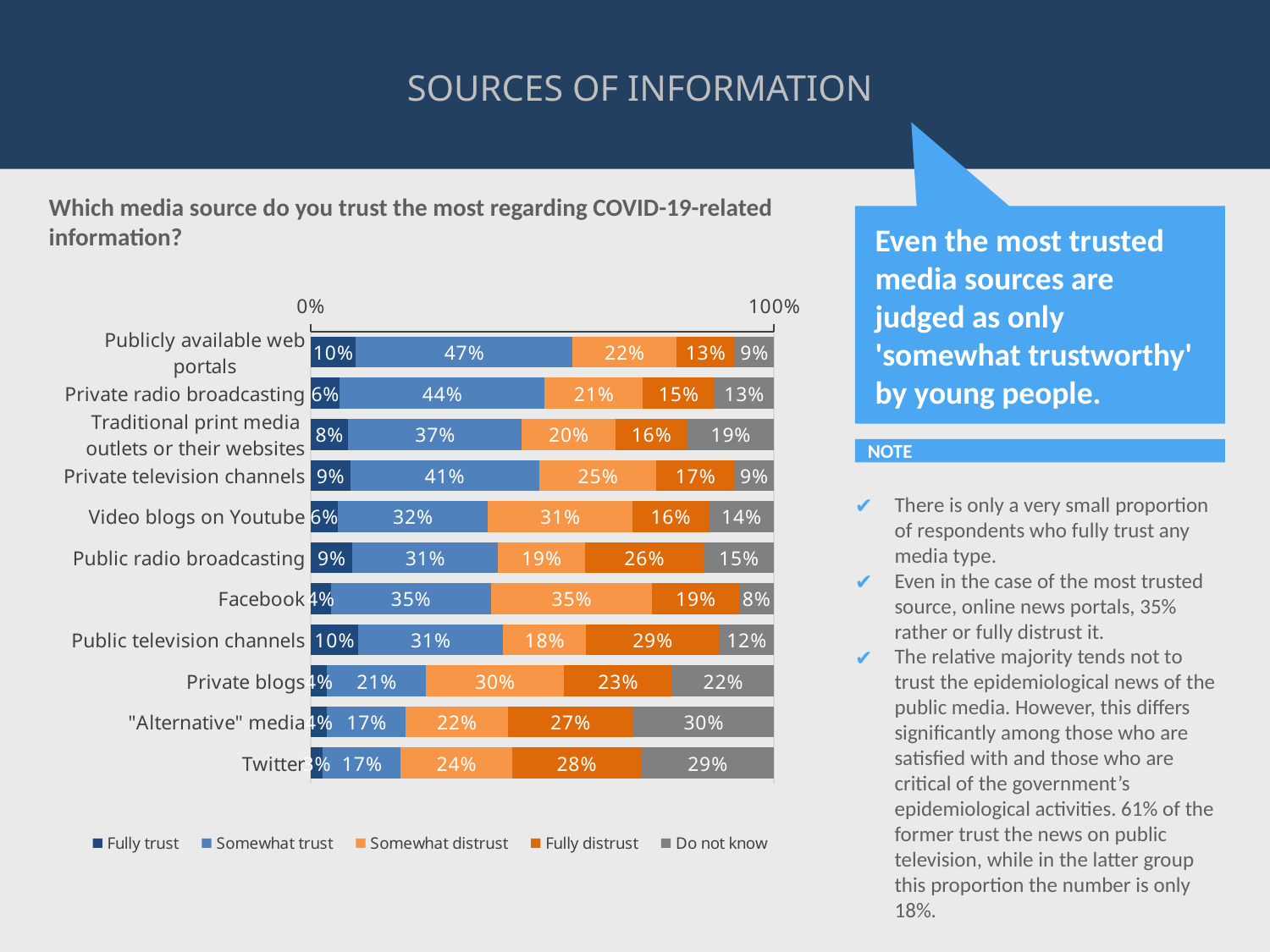
Which media source has the highest 'Somewhat trust' value? Publicly available web portals Which legend entry is shown in the darkest blue colour? Fully trust Which has a larger 'Fully distrust' value, Twitter or Private television channels? Twitter What type of chart is shown on the slide? Stacked bar chart How many series does the legend list? 5 Which media source has the lowest 'Do not know' value? Facebook What is the 'Do not know' value for "Alternative" media? 30% What percentage of respondents 'Somewhat trust' publicly available web portals? 47% How many media sources are listed on the chart? 11 What is the 'Fully distrust' value for public television channels? 29% What is the 'Somewhat distrust' value for Video blogs on Youtube? 31% What is the difference between the 'Somewhat trust' values for private radio broadcasting and public radio broadcasting? 13%